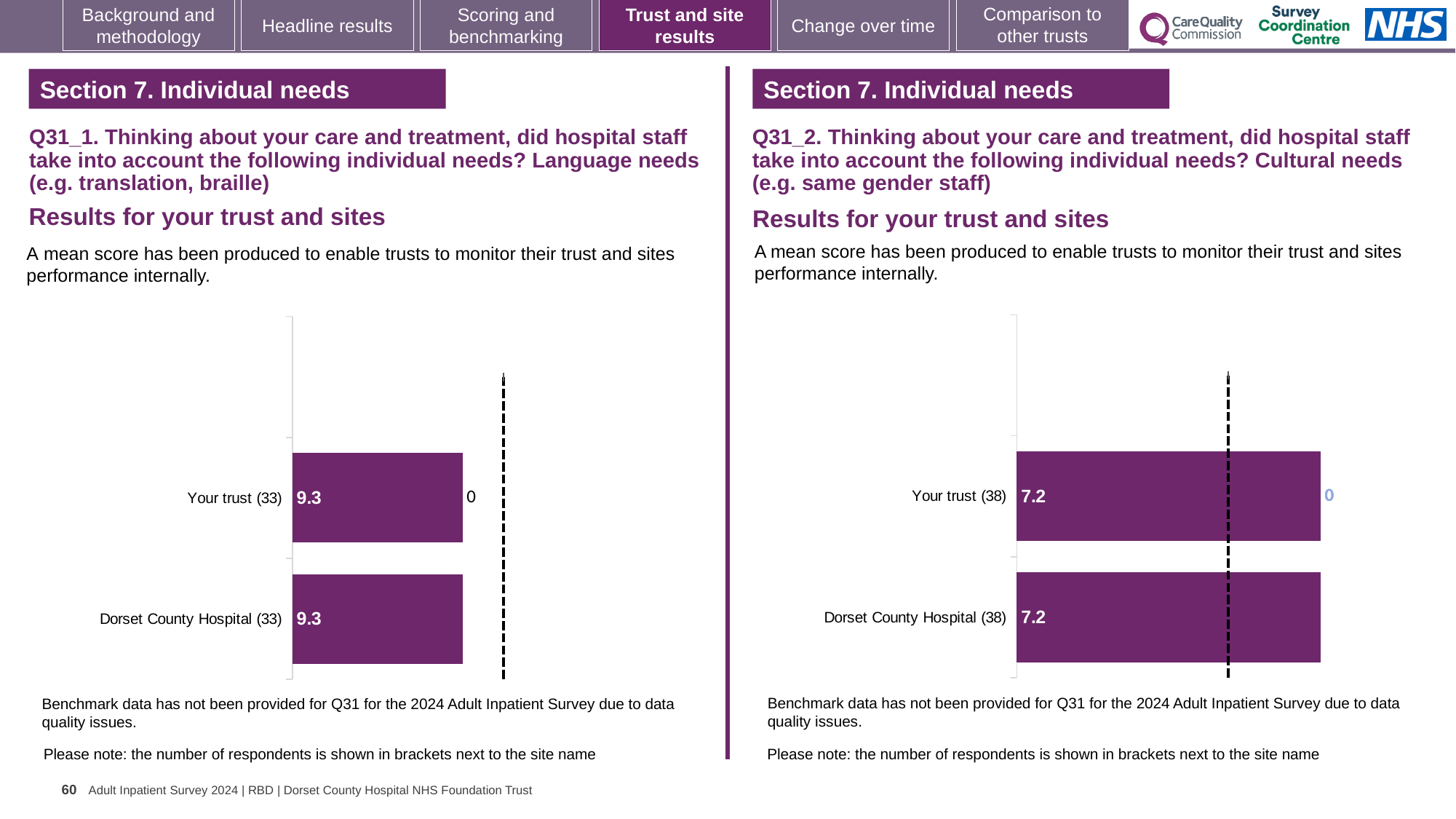
In the left chart (Q31_1, Language needs), how many respondents are shown in brackets next to Dorset County Hospital? 33 In the right chart (Q31_2, Cultural needs), what is the value for Dorset County Hospital? 7.2 How many bars are plotted in the left chart (Q31_1, Language needs)? 2 In the left chart (Q31_1, Language needs), what is the difference between the value for Your trust and the value for Dorset County Hospital? 0 In the right chart (Q31_2, Cultural needs), how many respondents are shown in brackets next to Your trust? 38 How many bars are plotted in the right chart (Q31_2, Cultural needs)? 2 What kind of chart is the right chart (Q31_2, Cultural needs)? Bar chart In the left chart (Q31_1, Language needs), what is the value for Dorset County Hospital? 9.3 In the right chart (Q31_2, Cultural needs), what is the value for Your trust? 7.2 In the left chart (Q31_1, Language needs), what is the value for Your trust? 9.3 In the right chart (Q31_2, Cultural needs), what is the difference between the value for Your trust and the value for Dorset County Hospital? 0 What kind of chart is the left chart (Q31_1, Language needs)? Bar chart